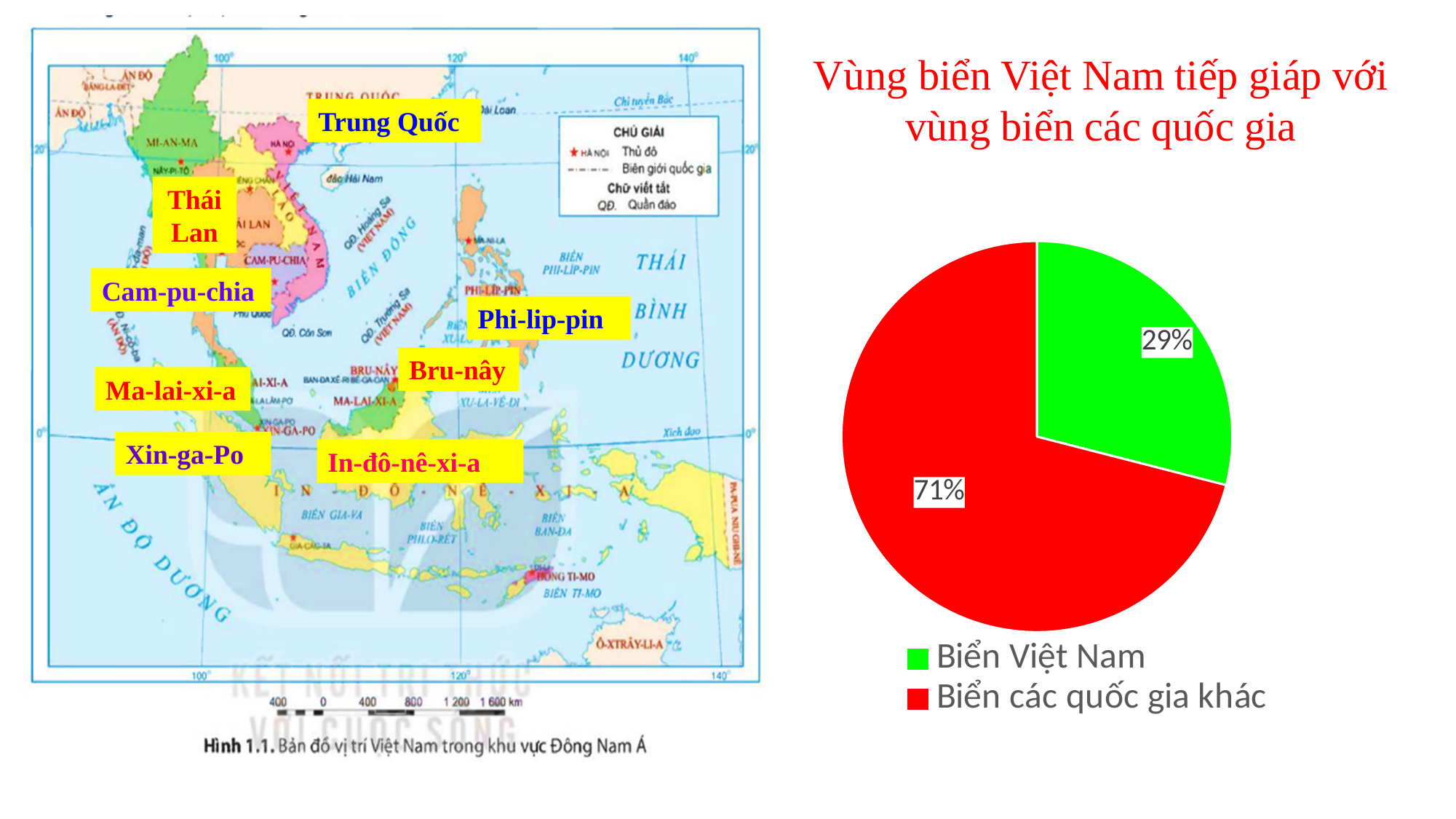
How many slices does the pie chart have? 2 What is the title of the pie chart? Vùng biển Việt Nam tiếp giáp với vùng biển các quốc gia What kind of chart is shown on the right side of the slide? pie chart What is the value shown for Biển Việt Nam in the pie chart? 29% Which slice of the pie chart is the smallest? Biển Việt Nam Which is larger in the pie chart: Biển Việt Nam or Biển các quốc gia khác? Biển các quốc gia khác What is the value shown for Biển các quốc gia khác in the pie chart? 71% Which slice of the pie chart is the largest? Biển các quốc gia khác What share of the pie chart does Biển Việt Nam represent? 29% What is the difference between the Biển các quốc gia khác share and the Biển Việt Nam share in the pie chart? 42% How many entries does the pie chart legend list? 2 What colour is the Biển Việt Nam slice in the pie chart? green